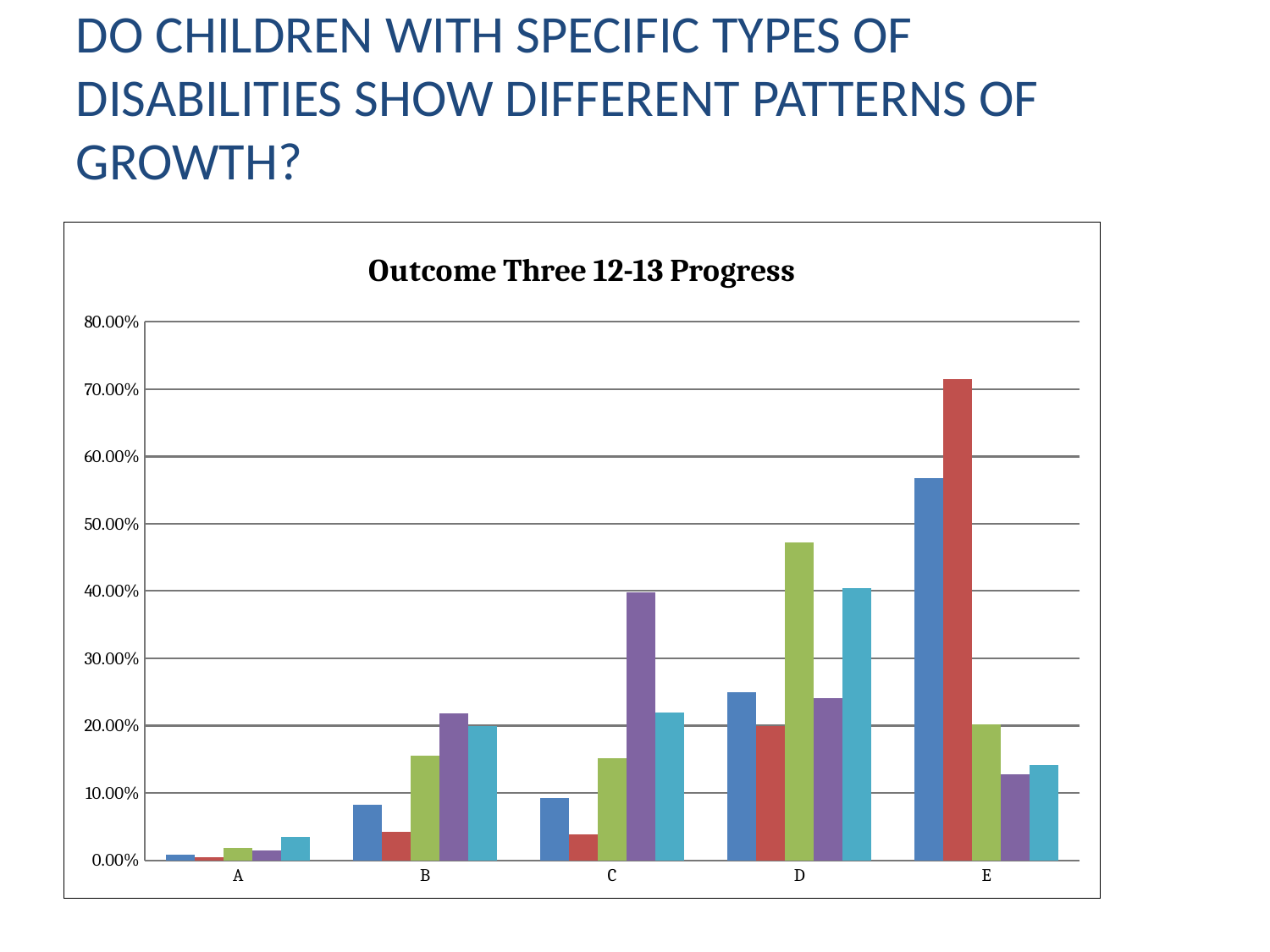
Which coloured bar is the lowest in category A? red Is the value of the blue bar in category E greater or less than 60.00%? less Do the blue bars rise or fall from category A to category E? rise Which coloured bar is the highest in category C? purple What is the title of the chart? Outcome Three 12-13 Progress How many categories are shown on the x axis of the chart? 5 Which coloured bar is the highest in category E? red Is the value of the red bar in category E greater or less than 60.00%? greater Which category contains the tallest bar in the chart? E What kind of chart is shown on the slide? bar chart Is the value of the blue bar in category D greater or less than 20.00%? greater